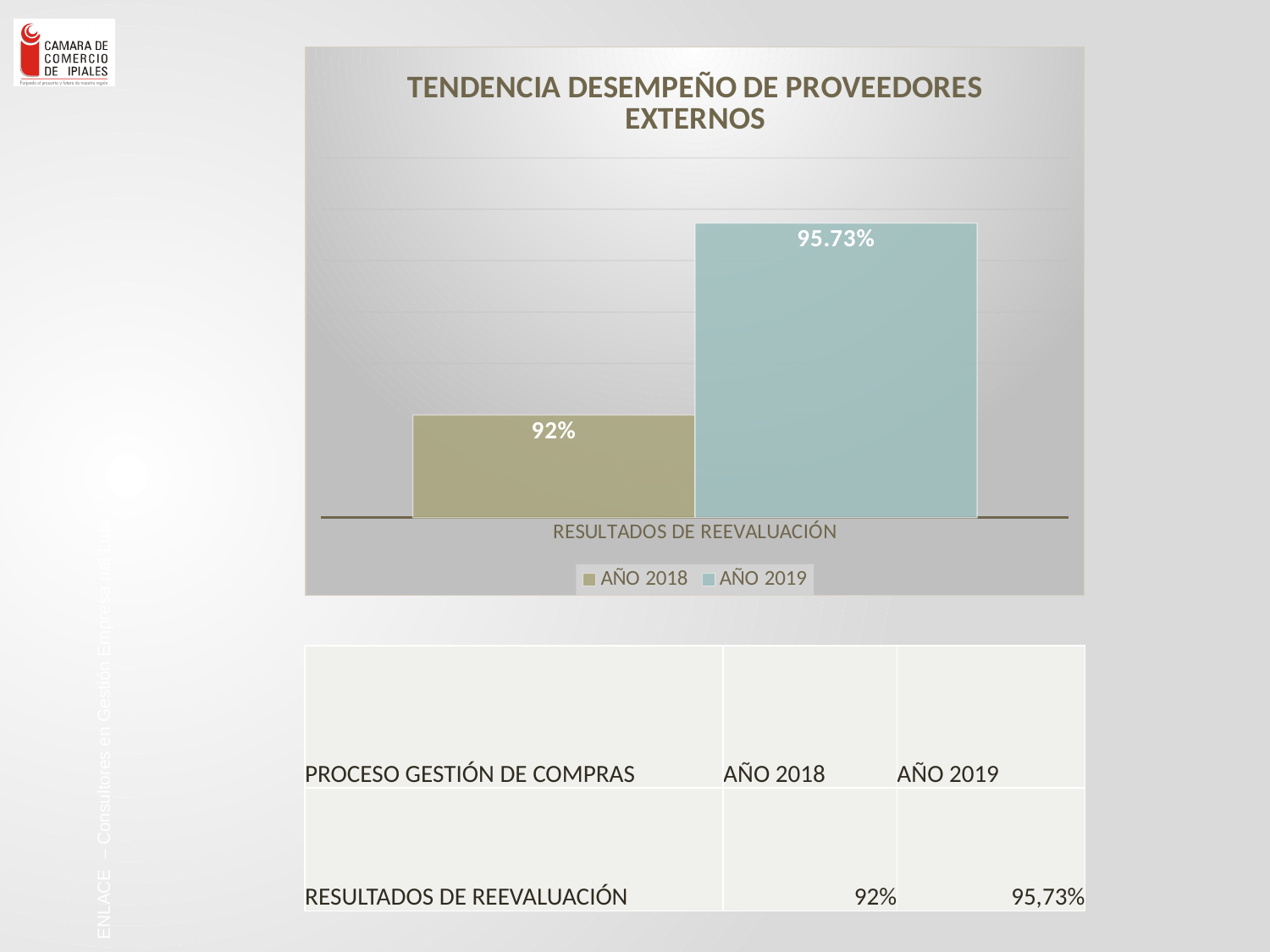
What is the category label shown on the x axis of the chart? RESULTADOS DE REEVALUACIÓN What kind of chart is shown on the slide? Bar chart How many series does the legend list? 2 What is the value for AÑO 2019 in the chart? 95.73% What is the difference between the AÑO 2019 value and the AÑO 2018 value? 3.73% What is the value for AÑO 2018 in the chart? 92% How many categories are shown on the x axis of the chart? 1 Do the values rise or fall from AÑO 2018 to AÑO 2019? Rise What is the title of the chart? TENDENCIA DESEMPEÑO DE PROVEEDORES EXTERNOS Which series has the highest value in the chart? AÑO 2019 Which series has the higher value, AÑO 2018 or AÑO 2019? AÑO 2019 Which series has the lowest value in the chart? AÑO 2018